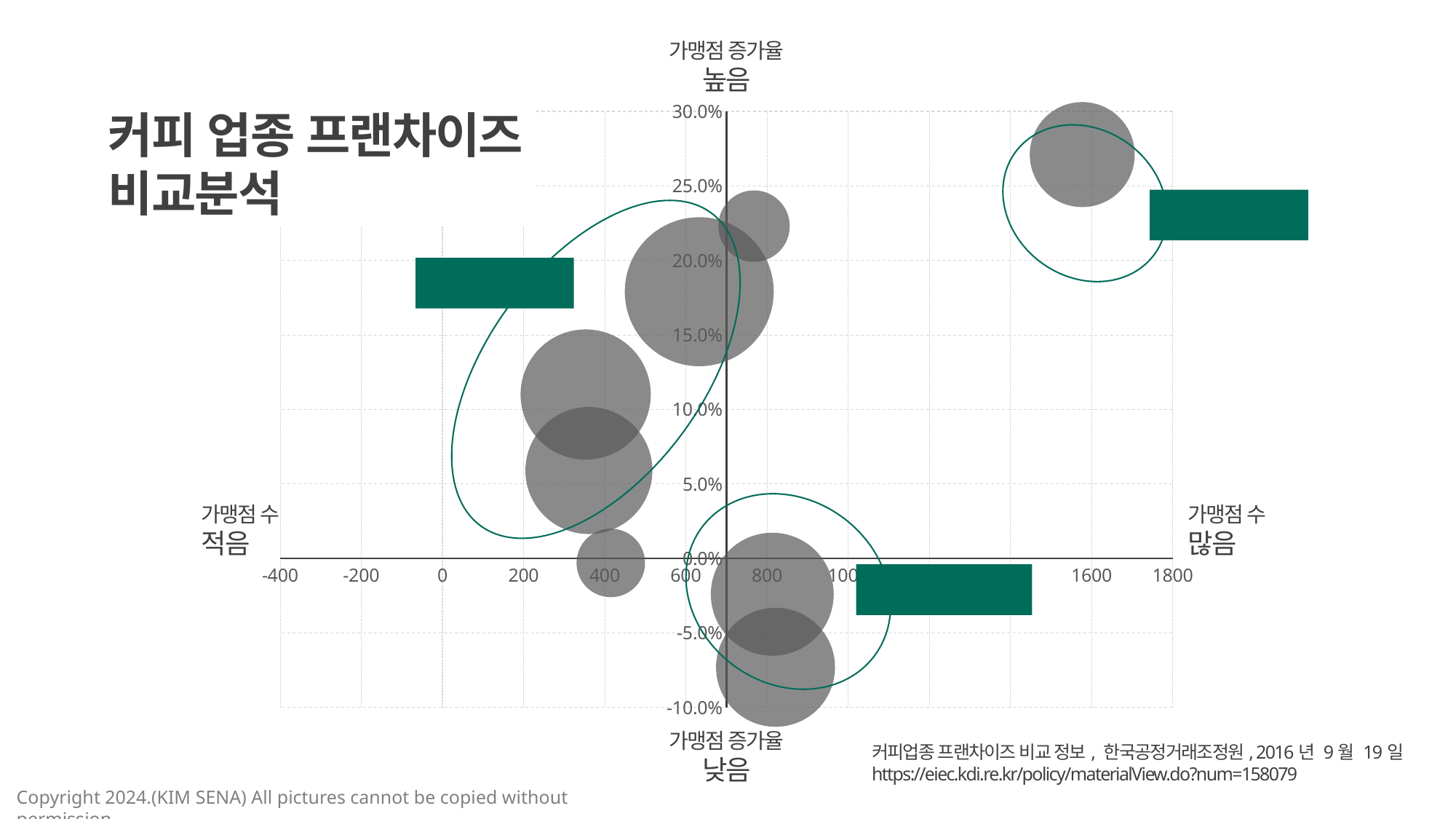
Is the vertical-axis value of the bubble in the top-right corner of the chart greater or less than 25.0%? greater What is the leftmost tick value on the horizontal axis? -400 What is the title of the slide? 커피 업종 프랜차이즈 비교분석 Is the vertical-axis value of the lowest bubble on the chart greater or less than -5.0%? less What is the highest value shown on the vertical axis? 30.0% What is the lowest value shown on the vertical axis? -10.0% What kind of chart is shown on the slide? bubble chart Is the horizontal-axis value of the bubble in the top-right corner of the chart greater or less than 1400? greater How many grey bubbles are plotted on the chart? 8 What is the rightmost tick value on the horizontal axis? 1800 What does the vertical axis of the chart represent, according to its label? 가맹점 증가율